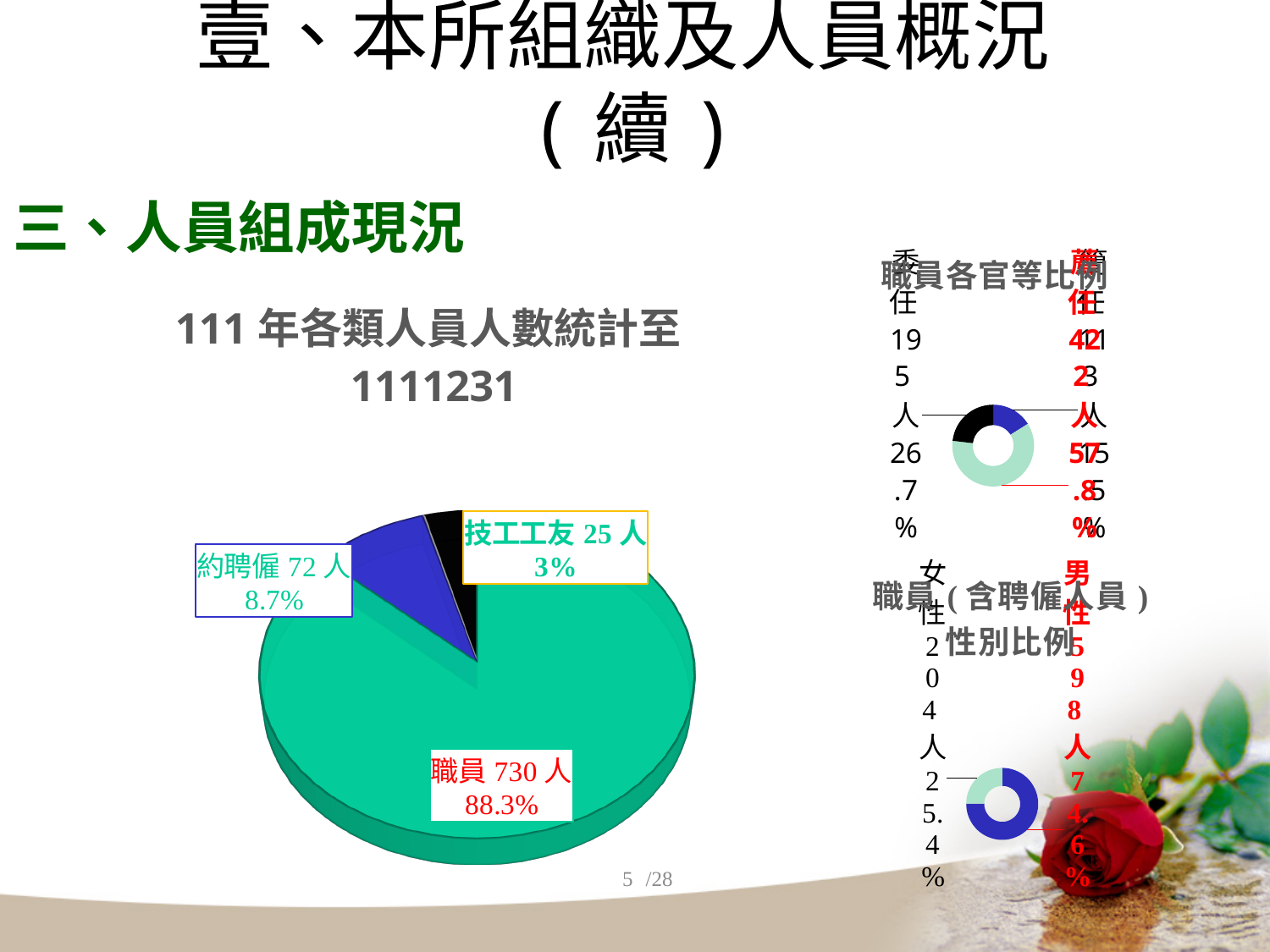
In the pie chart titled 111年各類人員人數統計至1111231, how many people are 技工工友? 25 人 In the pie chart titled 111年各類人員人數統計至1111231, which has more people, 約聘僱 or 技工工友? 約聘僱 In the chart titled 職員(含聘僱人員)性別比例, what percentage share is 男性? 74.6% In the chart titled 職員各官等比例, what percentage share is 委任? 26.7% In the pie chart titled 111年各類人員人數統計至1111231, what is the difference in headcount between 職員 and 約聘僱? 658 人 In the pie chart titled 111年各類人員人數統計至1111231, how many categories are shown? 3 What type of chart is the large chart on the left of the slide? Pie chart In the pie chart titled 111年各類人員人數統計至1111231, how many people are in the 職員 category? 730 人 In the pie chart titled 111年各類人員人數統計至1111231, what percentage share does 約聘僱 have? 8.7% In the pie chart titled 111年各類人員人數統計至1111231, which category is the smallest? 技工工友 In the pie chart titled 111年各類人員人數統計至1111231, which category is the largest? 職員 In the chart titled 職員(含聘僱人員)性別比例, how many people are 女性? 204 人